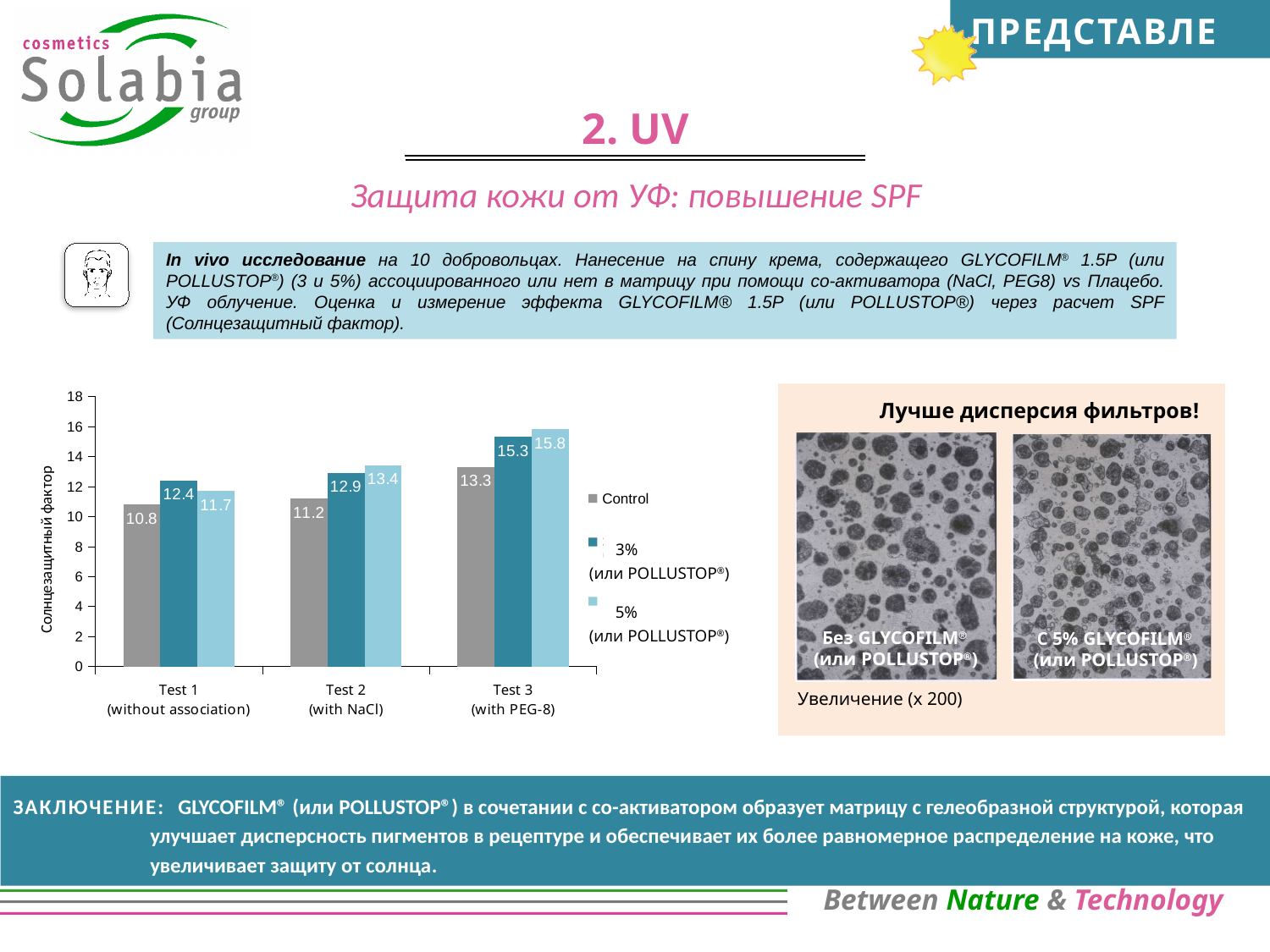
What is the Control value for Test 1 (without association)? 10.8 How many test categories are shown on the x axis? 3 Which test has the lowest value for the 5% series? Test 1 (without association) Which test has the highest Control value? Test 3 (with PEG-8) What kind of chart is shown on the slide? bar chart What is the value of the 3% series for Test 2 (with NaCl)? 12.9 What is the label of the y axis of the chart? Солнцезащитный фактор What is the difference between the 5% value and the Control value for Test 3 (with PEG-8)? 2.5 Is the Control value for Test 2 (with NaCl) greater or less than 12? less For Test 1 (without association), which is larger: the 3% value or the 5% value? 3% How many series does the legend list? 3 What is the value of the 5% series for Test 3 (with PEG-8)? 15.8